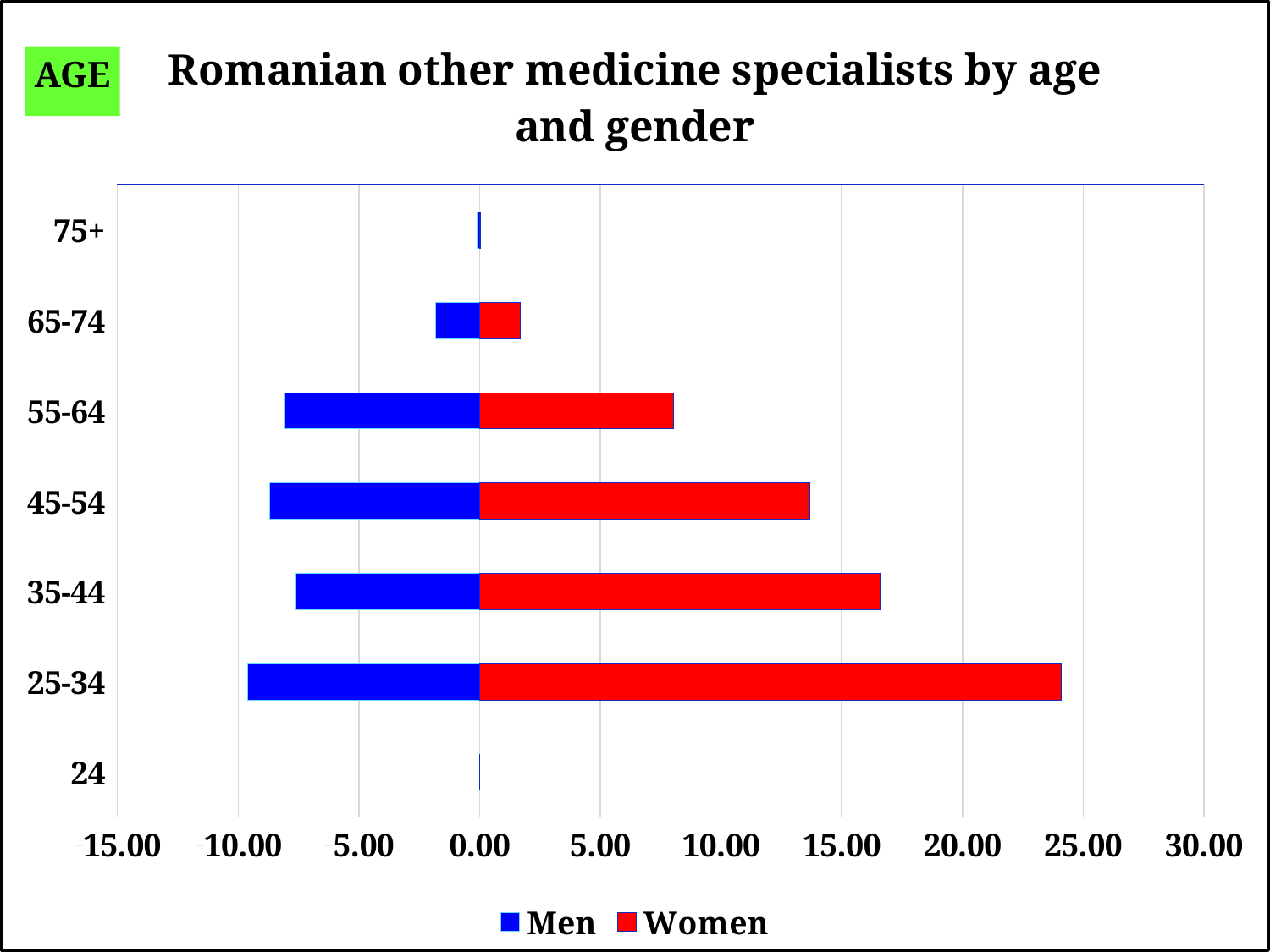
Is the Women value for 45-54 greater or less than 15.00? less Which is larger for the 35-44 age group, the Men bar or the Women bar? Women How many series does the legend list? 2 Which age group has the longest Women bar? 25-34 Which series is shown in red in the legend? Women Is the Women value for 25-34 greater or less than 20.00? greater Is the Women value for 35-44 greater or less than 15.00? greater Do the Women values rise or fall as the age groups go from 25-34 up to 65-74? fall How many age categories are shown on the chart? 7 What kind of chart is shown on the slide? bar chart Which age group has the longest Men bar? 25-34